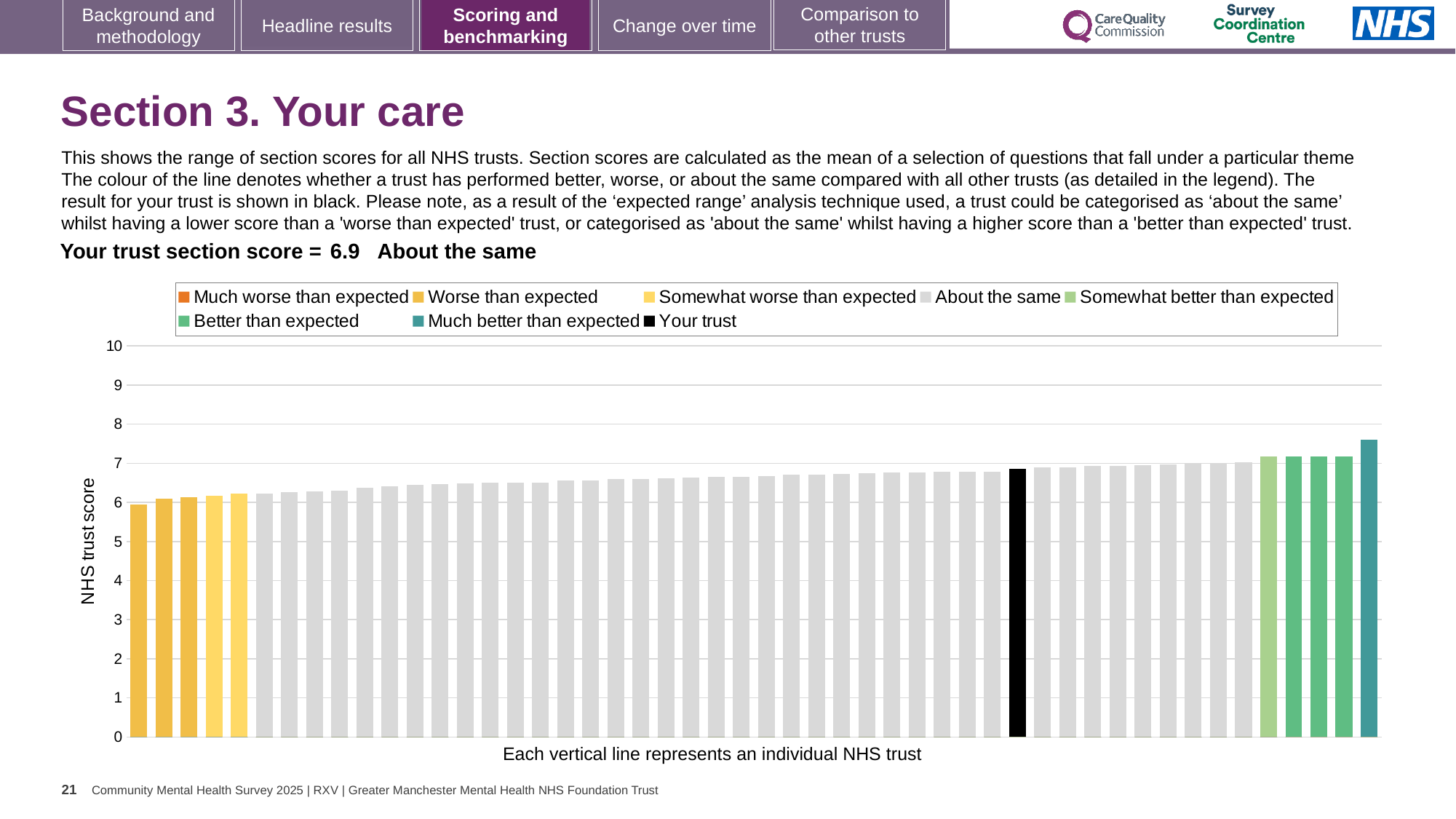
What kind of chart is shown on the slide? Bar chart Is the value of the black 'Your trust' bar greater or less than 6? greater Is the value of the tallest bar (the 'Much better than expected' trust) greater or less than 7? greater What is the section score for your trust? 6.9 How many bars are coloured as 'Much better than expected'? 1 Which legend category does the highest bar belong to? Much better than expected Do the bar values rise or fall from left to right along the x axis? rise Which category is your trust placed in for this section? About the same How many entries does the chart legend list? 8 What is the label on the vertical axis of the chart? NHS trust score Is the value of the shortest bar on the left greater or less than 5? greater How many bars are coloured as 'Better than expected'? 3